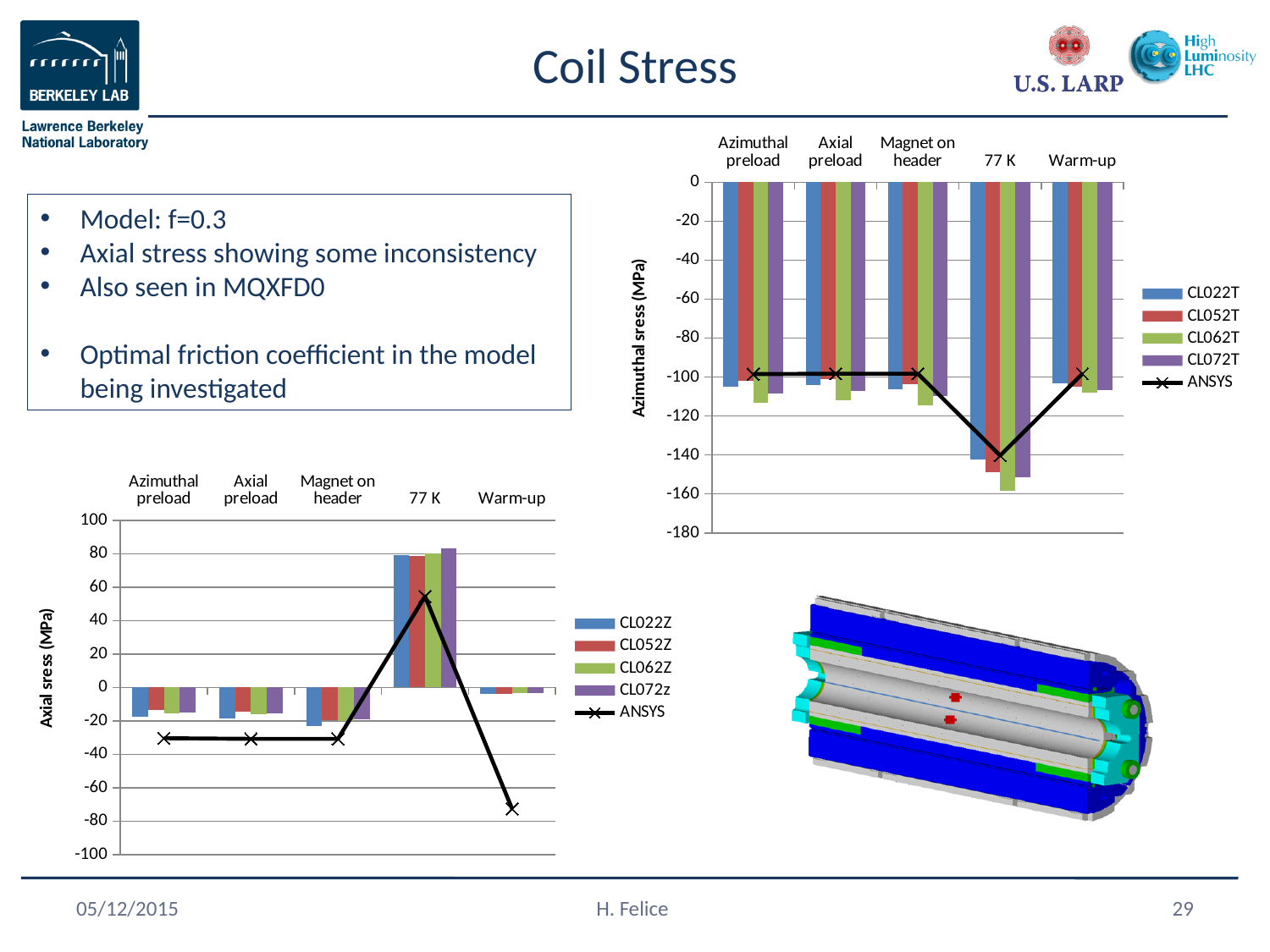
In the top-right chart, which series has the lowest value at 77 K? CL062T In the top-right chart, which category has the lowest (most negative) azimuthal stress values? 77 K In the top-right chart, does the ANSYS line rise or fall between Magnet on header and 77 K? fall In the top-right chart, is the CL062T value at Azimuthal preload greater or less than -100? less In the bottom-left chart, is the CL022Z value at 77 K greater or less than 60? greater In the top-right chart, how many series does the legend list? 5 In the top-right chart, is the CL062T value at 77 K greater or less than -140? less In the bottom-left chart, what kind of chart is used for the CL022Z, CL052Z, CL062Z and CL072z series? bar chart In the top-right chart, what is the y-axis title? Azimuthal sress (MPa) In the bottom-left chart, how many categories are shown on the x axis? 5 In the bottom-left chart, which category has the highest axial stress values? 77 K